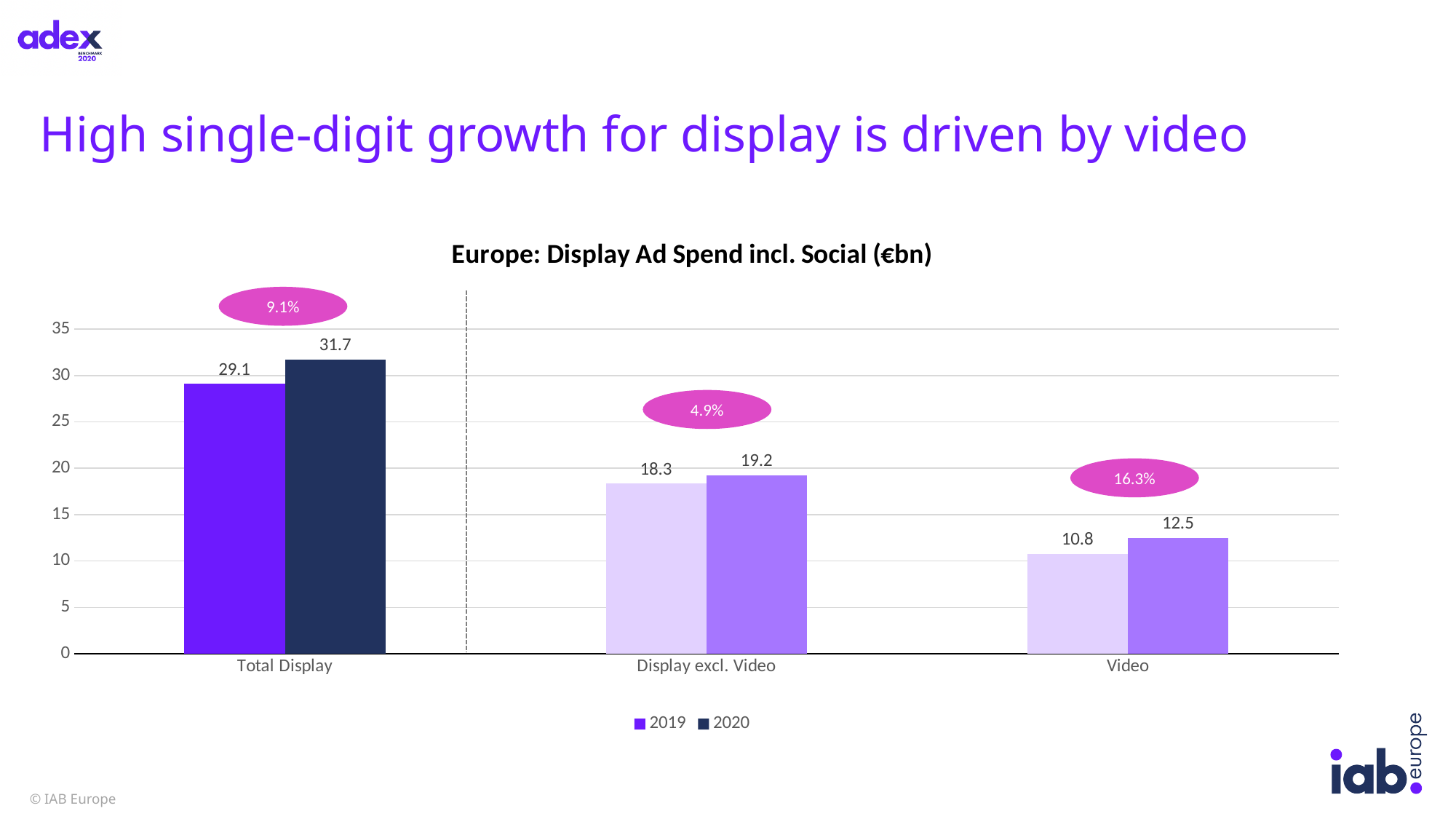
What is the 2020 value for Total Display? 31.7 What is the title of the chart? Europe: Display Ad Spend incl. Social (€bn) Which is larger: the 2019 value for Display excl. Video or the 2020 value for Video? 2019 value for Display excl. Video What is the difference between the 2020 and 2019 values for Total Display? 2.6 What growth percentage is shown above the Video bars? 16.3% What is the 2019 value for Video? 10.8 What is the difference between the 2020 values for Display excl. Video and Video? 6.7 Which category has the lowest 2019 value? Video Which category has the highest 2020 value? Total Display What is the 2019 value for Display excl. Video? 18.3 How many categories are shown on the x axis? 3 How many series does the legend list? 2